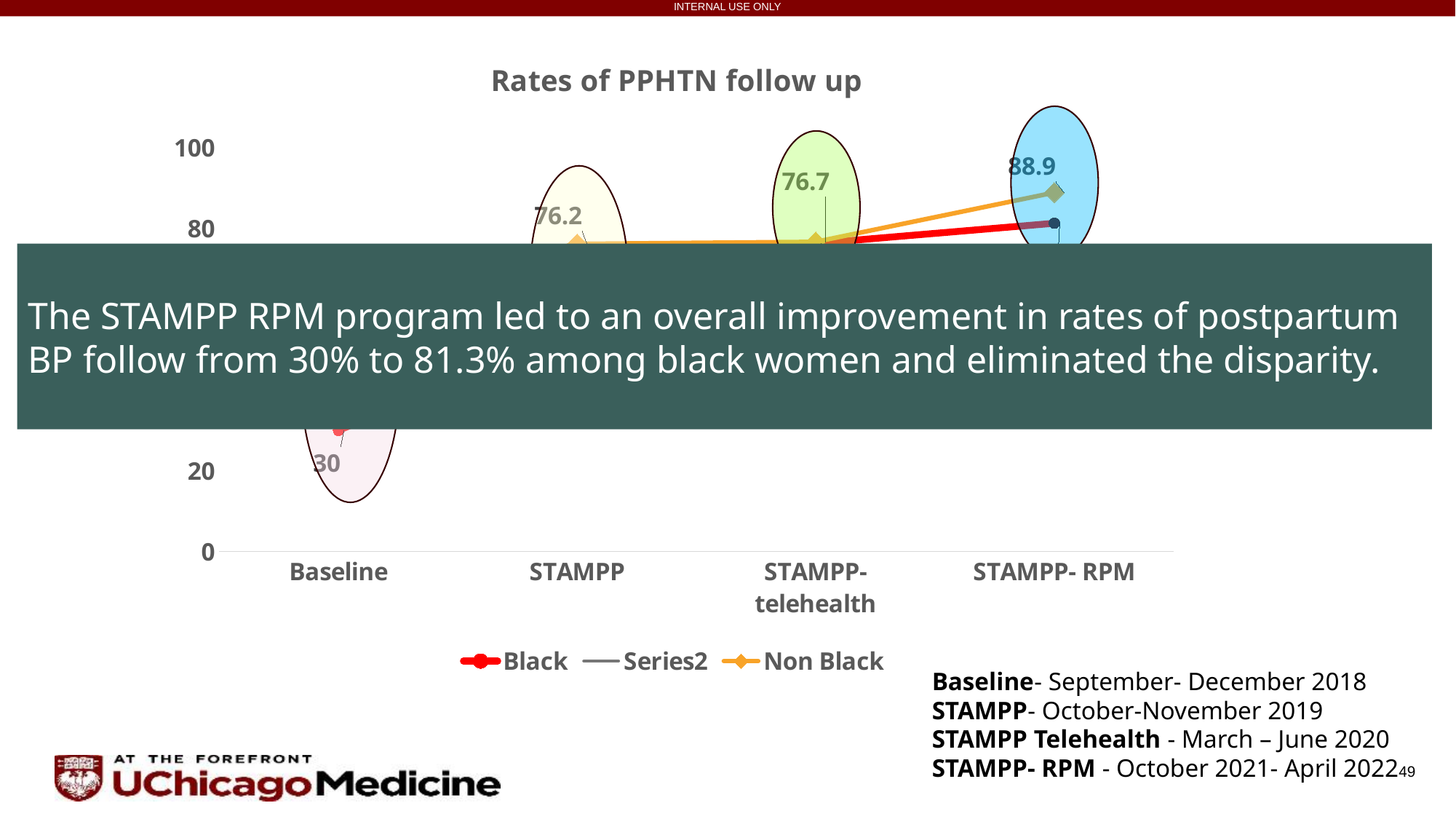
Which category has the highest labeled value on the chart? STAMPP- RPM What value is labeled at the STAMPP category? 76.2 What are the series names listed in the chart legend? Black, Series2, Non Black Is the value for the Black series at Baseline greater or less than 40? less What is the value for the Black series at Baseline? 30 What kind of chart is shown on the slide? line chart What is the value labeled at STAMPP- RPM for the Non Black series? 88.9 What is the title of the chart? Rates of PPHTN follow up How many categories are shown on the x axis of the chart? 4 How many series does the chart legend list? 3 What is the difference between the labeled value at STAMPP- RPM (88.9) and the labeled value at STAMPP (76.2)? 12.7 What value is labeled at the STAMPP-telehealth category? 76.7